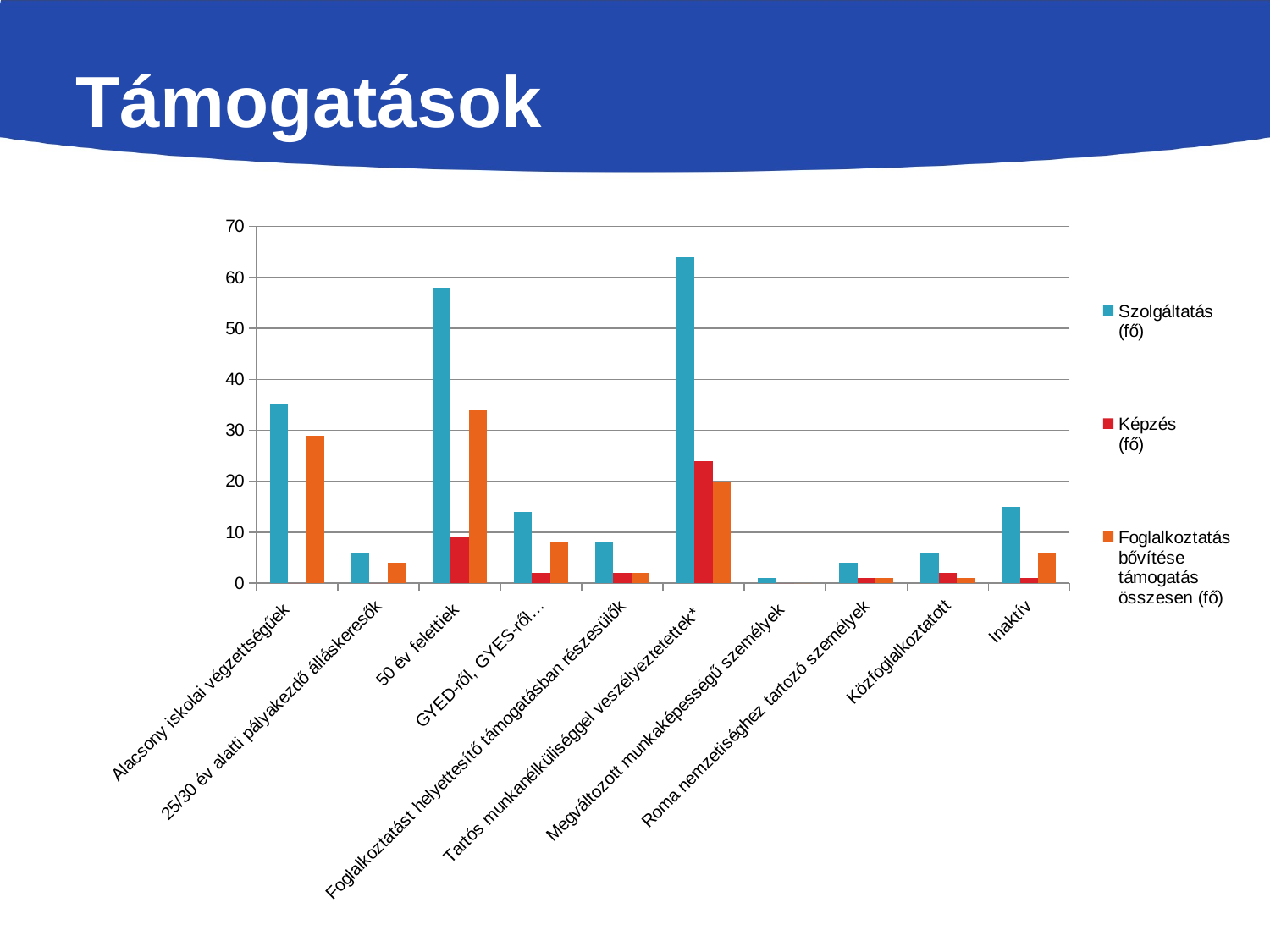
Which series is shown in red in the legend? Képzés (fő) Is the Szolgáltatás (fő) value for 50 év felettiek greater or less than 50? greater What kind of chart is shown on the slide? bar chart Which category has the highest Szolgáltatás (fő) value? Tartós munkanélküliséggel veszélyeztetettek* Which category has the highest Képzés (fő) value? Tartós munkanélküliséggel veszélyeztetettek* Which is larger for 50 év felettiek: the Képzés (fő) value or the Foglalkoztatás bővítése támogatás összesen (fő) value? Foglalkoztatás bővítése támogatás összesen (fő) Is the Foglalkoztatás bővítése támogatás összesen (fő) value for Alacsony iskolai végzettségűek greater or less than 20? greater Is the Szolgáltatás (fő) value for Inaktív greater or less than 20? less How many series does the legend list? 3 How many categories are shown on the x axis? 10 Which category has the highest Foglalkoztatás bővítése támogatás összesen (fő) value? 50 év felettiek